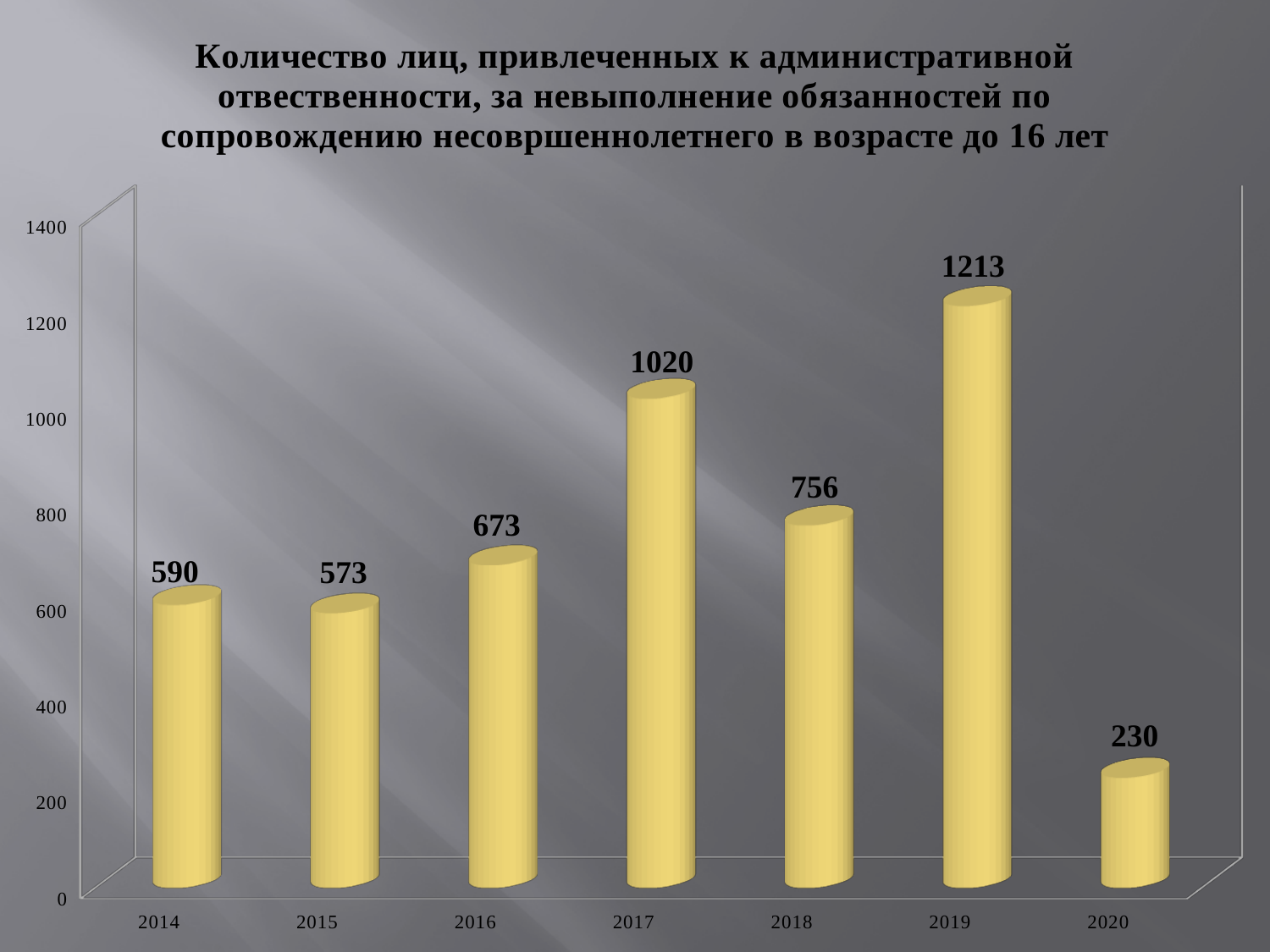
Which is larger, the value for 2014 or the value for 2015? 2014 Which year has the highest value? 2019 What is the value for 2017? 1020 How many years are shown on the x axis? 7 What is the value for 2020? 230 What is the value for 2014? 590 What kind of chart is shown on the slide? bar chart What is the difference between the values for 2019 and 2018? 457 Do the values rise or fall from 2019 to 2020? fall Is the value for 2018 greater or less than 800? less Which year has the lowest value? 2020 What is the difference between the values for 2016 and 2015? 100